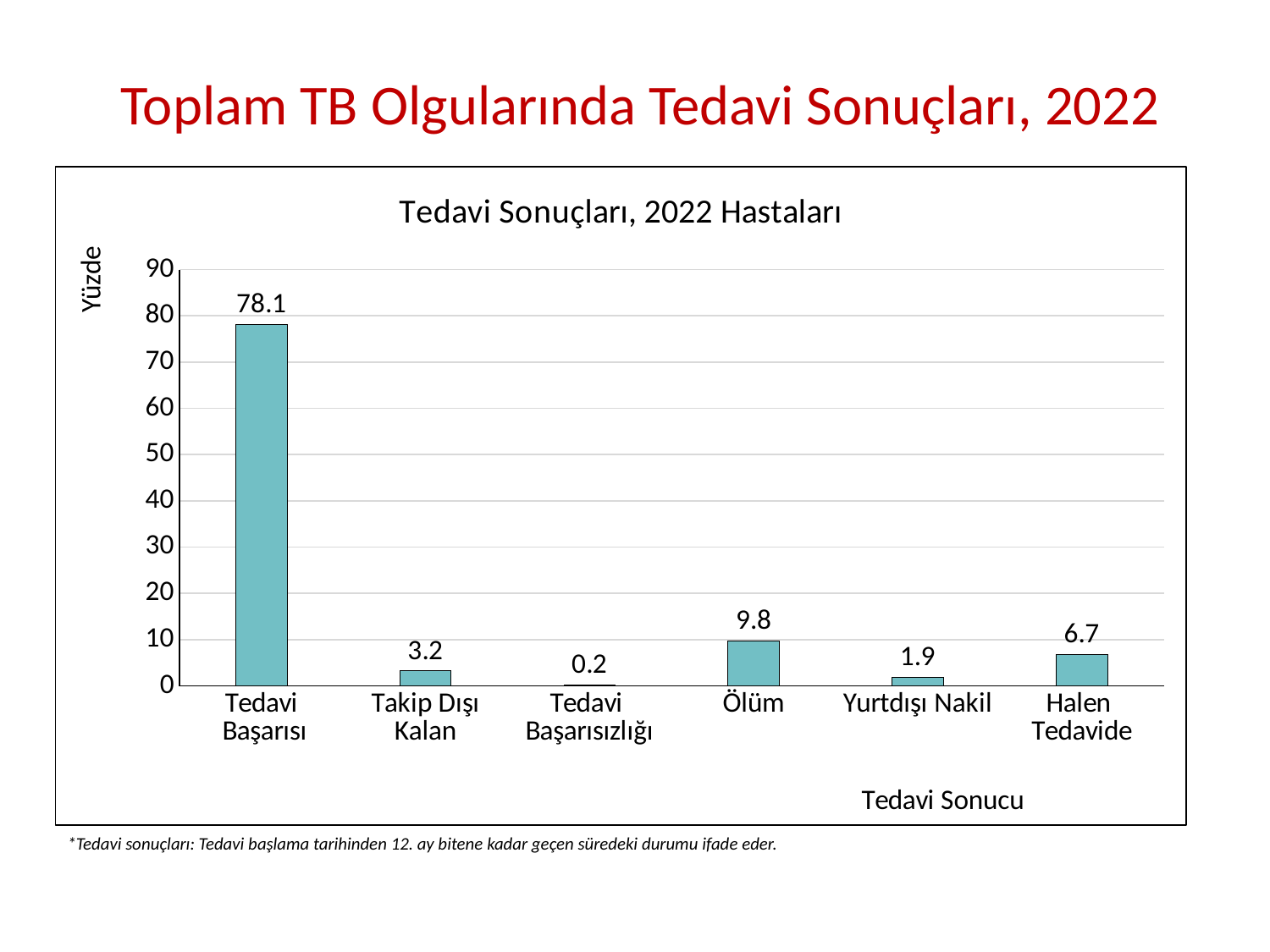
Which is larger, the value for Takip Dışı Kalan or the value for Halen Tedavide? Halen Tedavide Which category has the lowest value? Tedavi Başarısızlığı Which category has the highest value? Tedavi Başarısı What is the label of the y axis? Yüzde Is the value for Tedavi Başarısı greater or less than 70? greater What is the value for Tedavi Başarısı? 78.1 What kind of chart is shown? bar chart What is the title of the chart? Tedavi Sonuçları, 2022 Hastaları What is the value for Ölüm? 9.8 What is the difference between the values for Ölüm and Halen Tedavide? 3.1 What is the value for Yurtdışı Nakil? 1.9 How many categories are shown on the x axis? 6